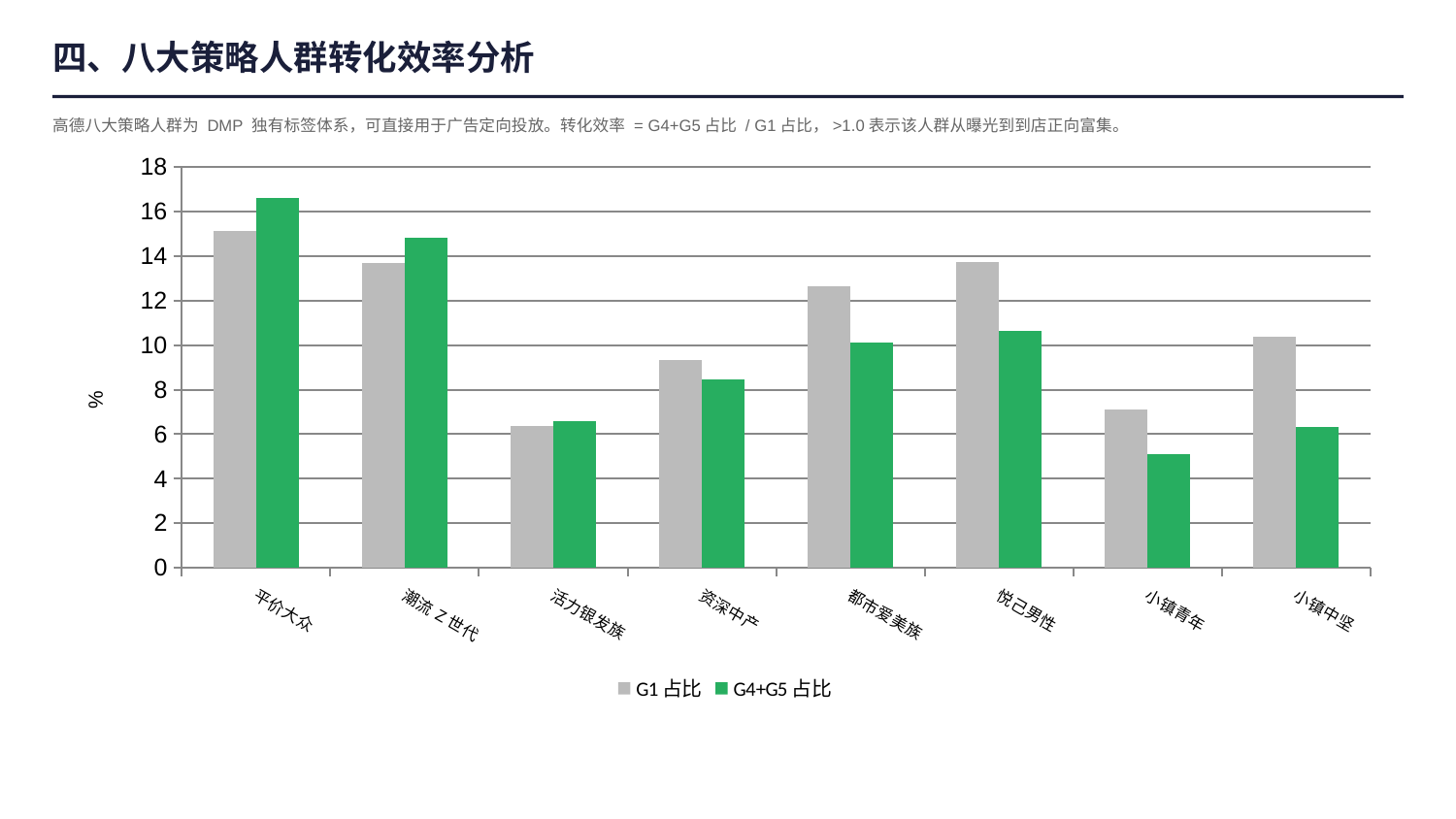
Which category has the lowest G4+G5 占比 value? 小镇青年 How many series does the chart's legend list? 2 Which category has the highest G4+G5 占比 value? 平价大众 What kind of chart is shown on the slide? bar chart What are the two series named in the legend? G1 占比 and G4+G5 占比 Which category has the highest G1 占比 value? 平价大众 Which category has the lowest G1 占比 value? 活力银发族 For 小镇中坚, which is larger: G1 占比 or G4+G5 占比? G1 占比 Is the G1 占比 value for 悦己男性 greater or less than 12? greater Is the G4+G5 占比 value for 平价大众 greater or less than 16? greater Is the G4+G5 占比 value for 小镇青年 greater or less than 6? less How many categories (人群) are shown on the x axis of the chart? 8